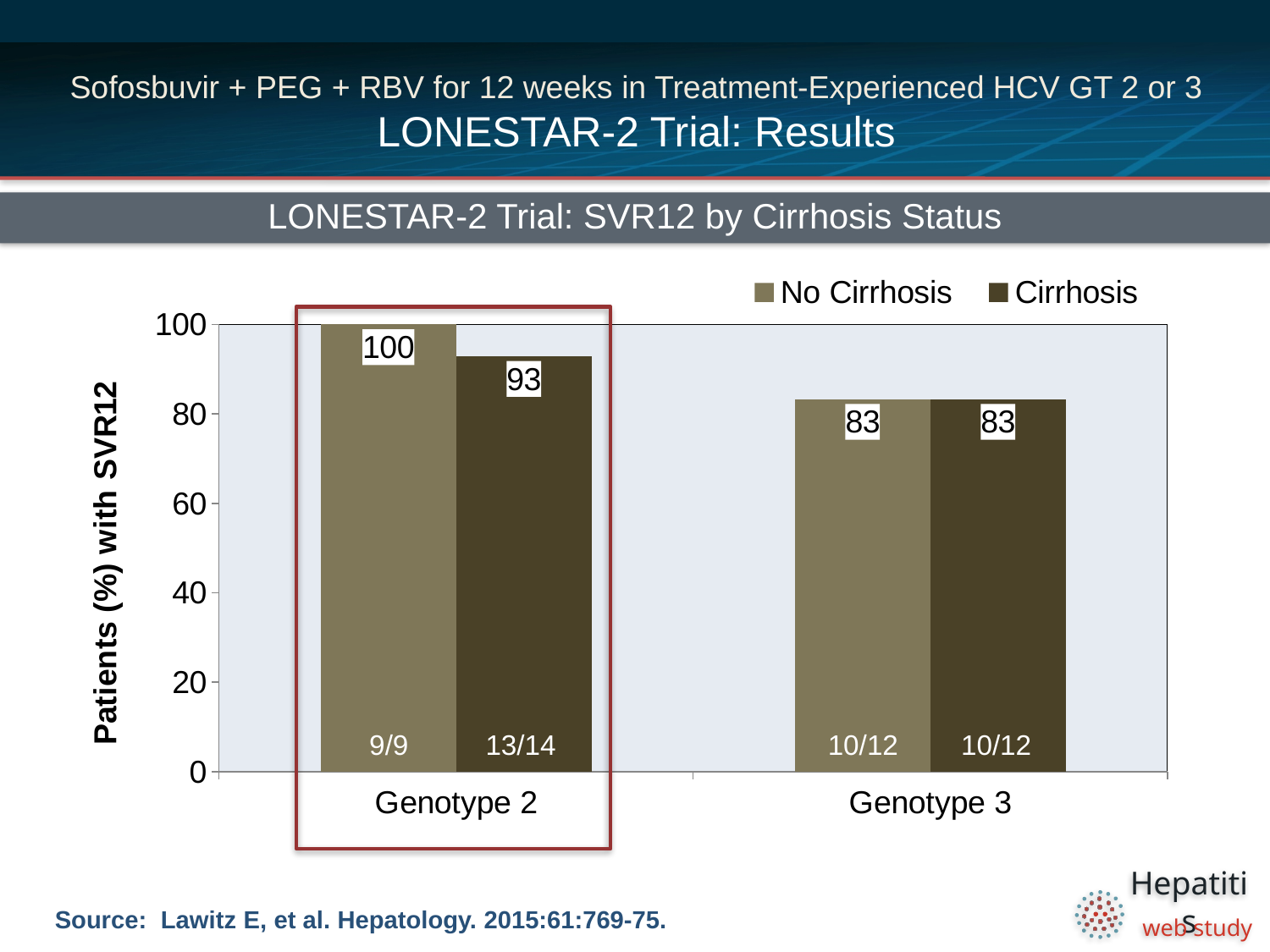
What is the difference in SVR12 rate between No Cirrhosis patients with Genotype 2 and No Cirrhosis patients with Genotype 3? 17 How many patients achieved SVR12 out of the total in the Cirrhosis group with Genotype 2? 13/14 What is the SVR12 rate for No Cirrhosis patients with Genotype 2? 100 How many series does the legend list? 2 What is the SVR12 rate for Cirrhosis patients with Genotype 2? 93 Which is larger: the SVR12 rate for Cirrhosis patients with Genotype 2 or Cirrhosis patients with Genotype 3? Genotype 2 What is the SVR12 rate for Cirrhosis patients with Genotype 3? 83 What type of chart is shown on the slide? Bar chart What is the SVR12 rate for No Cirrhosis patients with Genotype 3? 83 What is the difference in SVR12 rate between No Cirrhosis and Cirrhosis patients with Genotype 2? 7 How many genotype categories are shown on the x axis? 2 Which bar shows the highest SVR12 rate? No Cirrhosis, Genotype 2